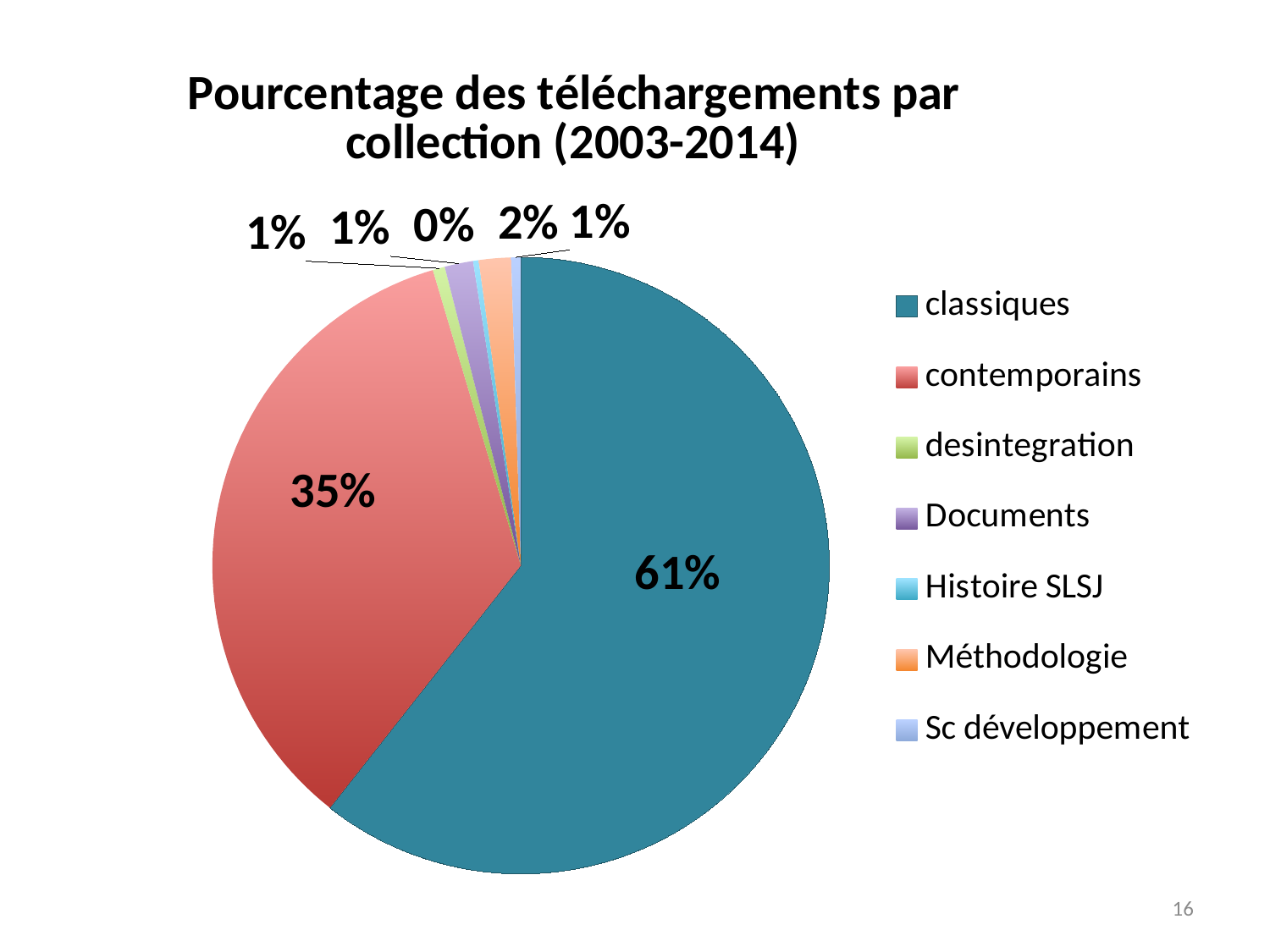
Which has a larger share of downloads, contemporains or Méthodologie? contemporains What percentage of downloads does the contemporains collection account for? 35% What is the title of the chart? Pourcentage des téléchargements par collection (2003-2014) What percentage is shown for the Histoire SLSJ slice? 0% How many percentage points larger is the classiques share than the contemporains share? 26 Which collection has the smallest share of downloads? Histoire SLSJ What colour is the slice representing the classiques collection? teal blue What percentage of downloads does the classiques collection account for? 61% What type of chart is shown on the slide? pie chart Which collection has the largest share of downloads? classiques How many collections are listed in the legend? 7 What percentage is shown for the Méthodologie slice? 2%